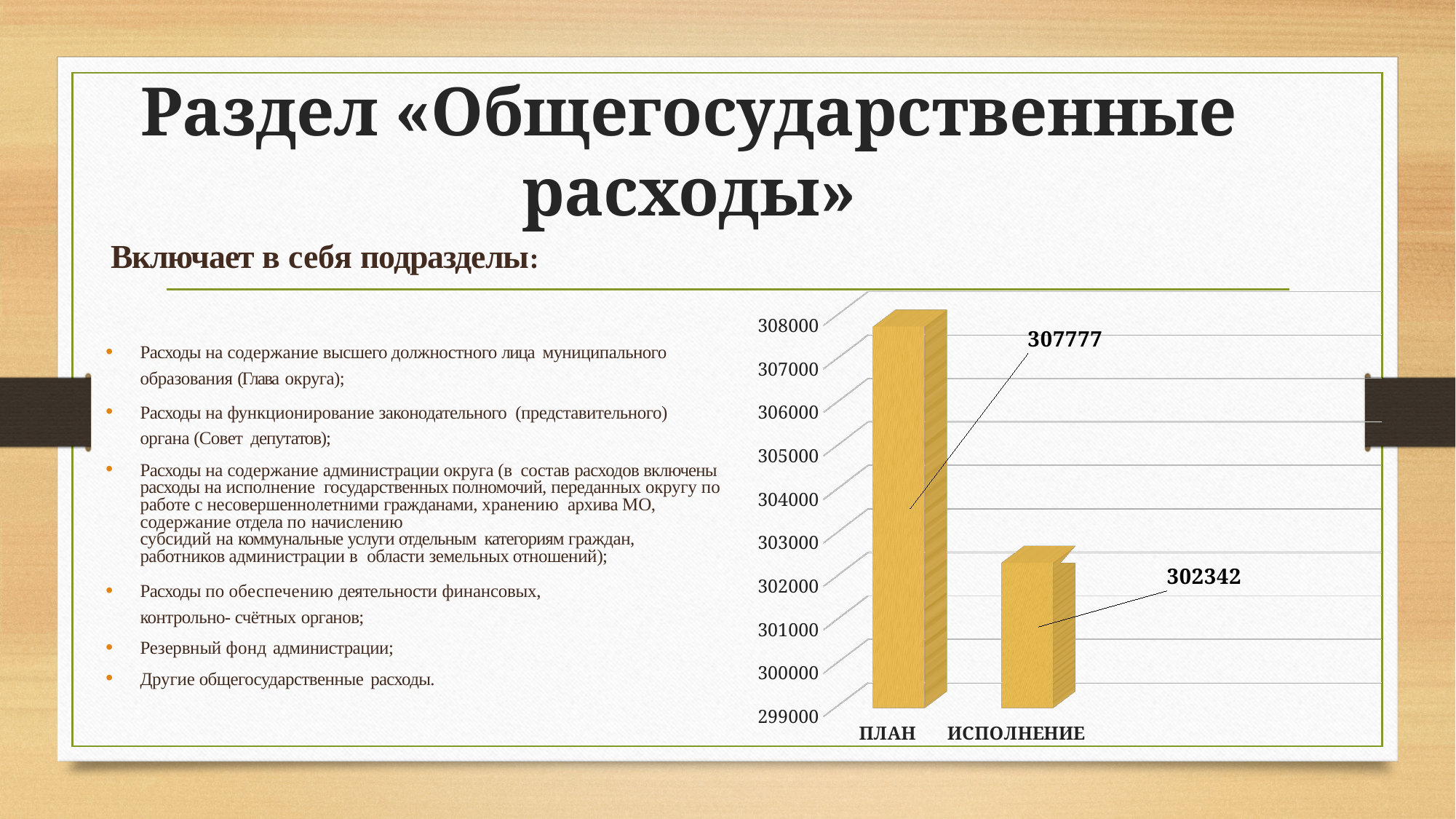
Is the value for ПЛАН greater or less than 306000? greater What kind of chart is shown on the slide? bar chart What is the difference between the values for ПЛАН and ИСПОЛНЕНИЕ? 5435 Which is larger, the value for ПЛАН or the value for ИСПОЛНЕНИЕ? ПЛАН What is the value for ИСПОЛНЕНИЕ? 302342 How many categories are shown on the x axis of the chart? 2 Which category has the lowest value? ИСПОЛНЕНИЕ Is the value for ИСПОЛНЕНИЕ greater or less than 303000? less What is the lowest value shown on the vertical axis of the chart? 299000 Do the values rise or fall from ПЛАН to ИСПОЛНЕНИЕ? fall Which category has the highest value? ПЛАН What is the value for ПЛАН? 307777